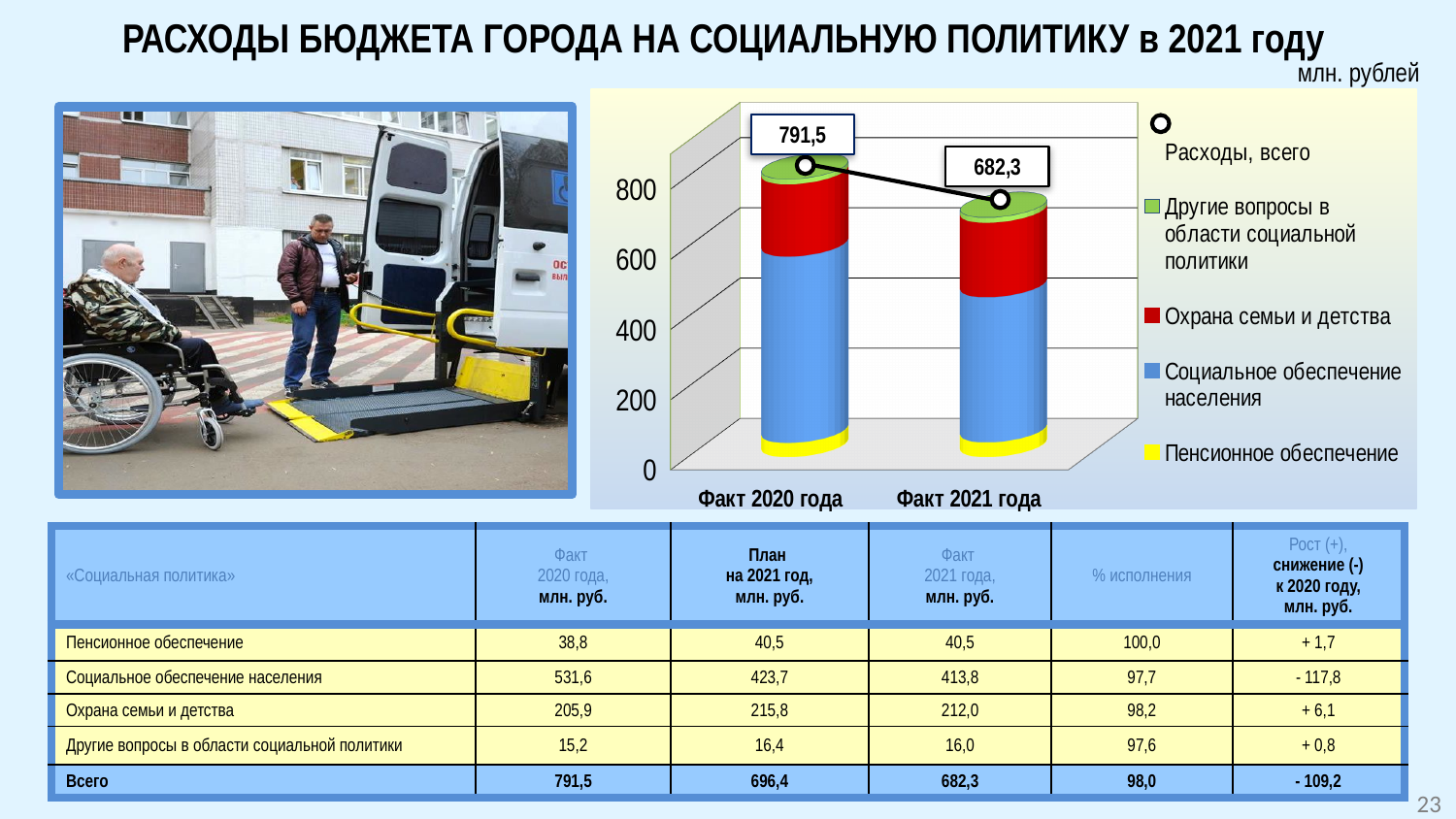
How many categories are shown on the x axis of the chart? 2 What is the difference between the total expenditure for Факт 2020 года and Факт 2021 года? 109,2 Which category has the higher total expenditure, Факт 2020 года or Факт 2021 года? Факт 2020 года What is the value of the 'Расходы, всего' line for Факт 2021 года? 682,3 Is the total for Факт 2021 года greater or less than 800? less Which series is shown in red in the chart? Охрана семьи и детства What is the value of the 'Расходы, всего' line for Факт 2020 года? 791,5 How many entries does the chart legend list? 5 Is the total for Факт 2020 года greater or less than 600? greater Which category has the lowest total expenditure? Факт 2021 года Do total expenditures rise or fall from Факт 2020 года to Факт 2021 года? fall What kind of chart is shown on the slide? stacked bar chart